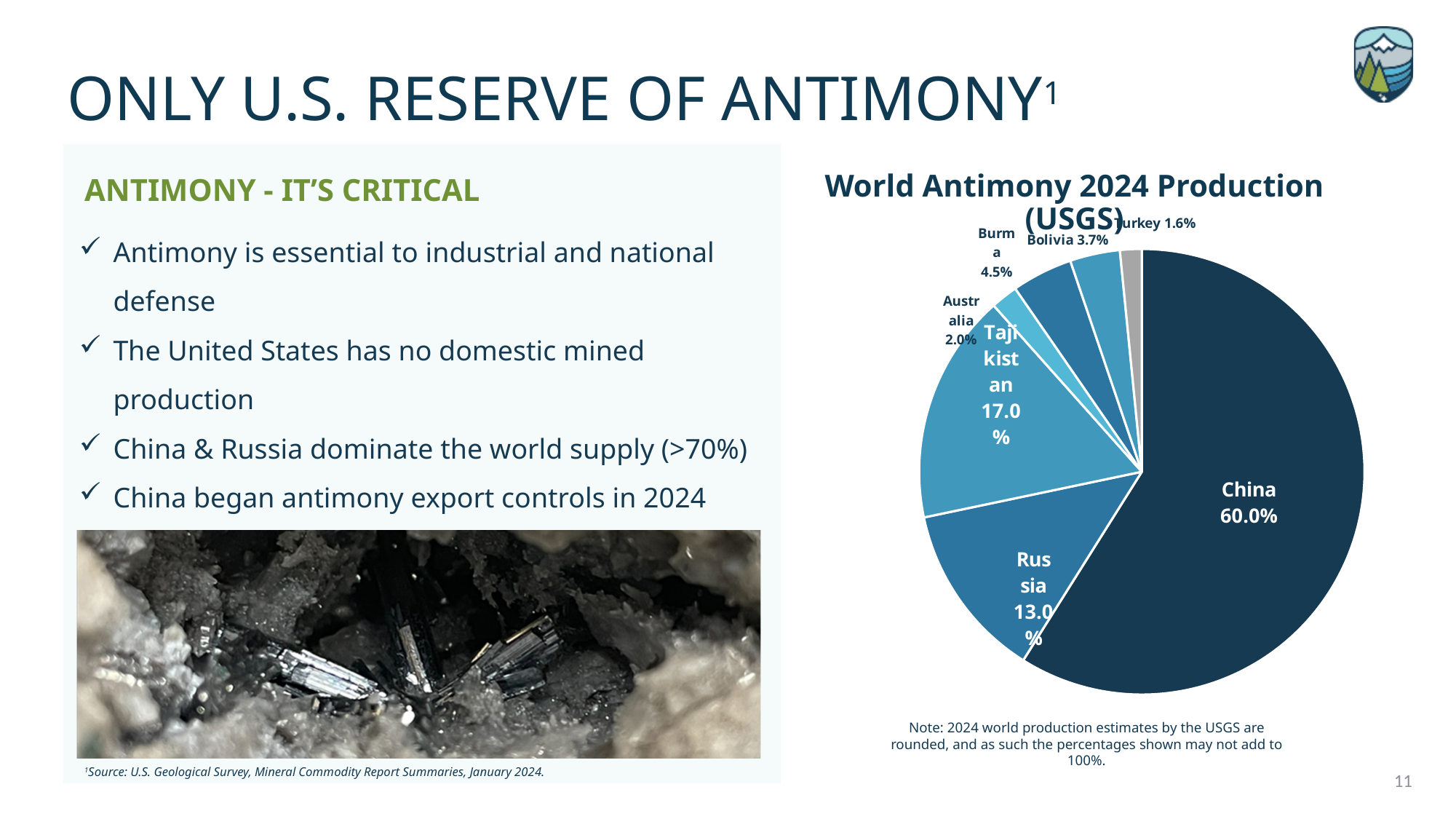
What is the title of the chart on the slide? World Antimony 2024 Production (USGS) What is Russia's share of 2024 world antimony production according to the chart? 13.0% Which country has the largest slice in the World Antimony 2024 Production pie chart? China What percentage does Burma contribute to 2024 world antimony production? 4.5% What share of world antimony production in 2024 does China account for in the pie chart? 60.0% How many countries are shown as slices in the World Antimony 2024 Production pie chart? 7 How many percentage points larger is Tajikistan's share than Russia's share of 2024 antimony production? 4.0 What is Bolivia's share in the World Antimony 2024 Production chart? 3.7% Which country has the smallest slice in the World Antimony 2024 Production pie chart? Turkey Which has a larger share of 2024 world antimony production, Burma or Bolivia? Burma What type of chart is used to show World Antimony 2024 Production? Pie chart What percentage of 2024 world antimony production is attributed to Tajikistan? 17.0%